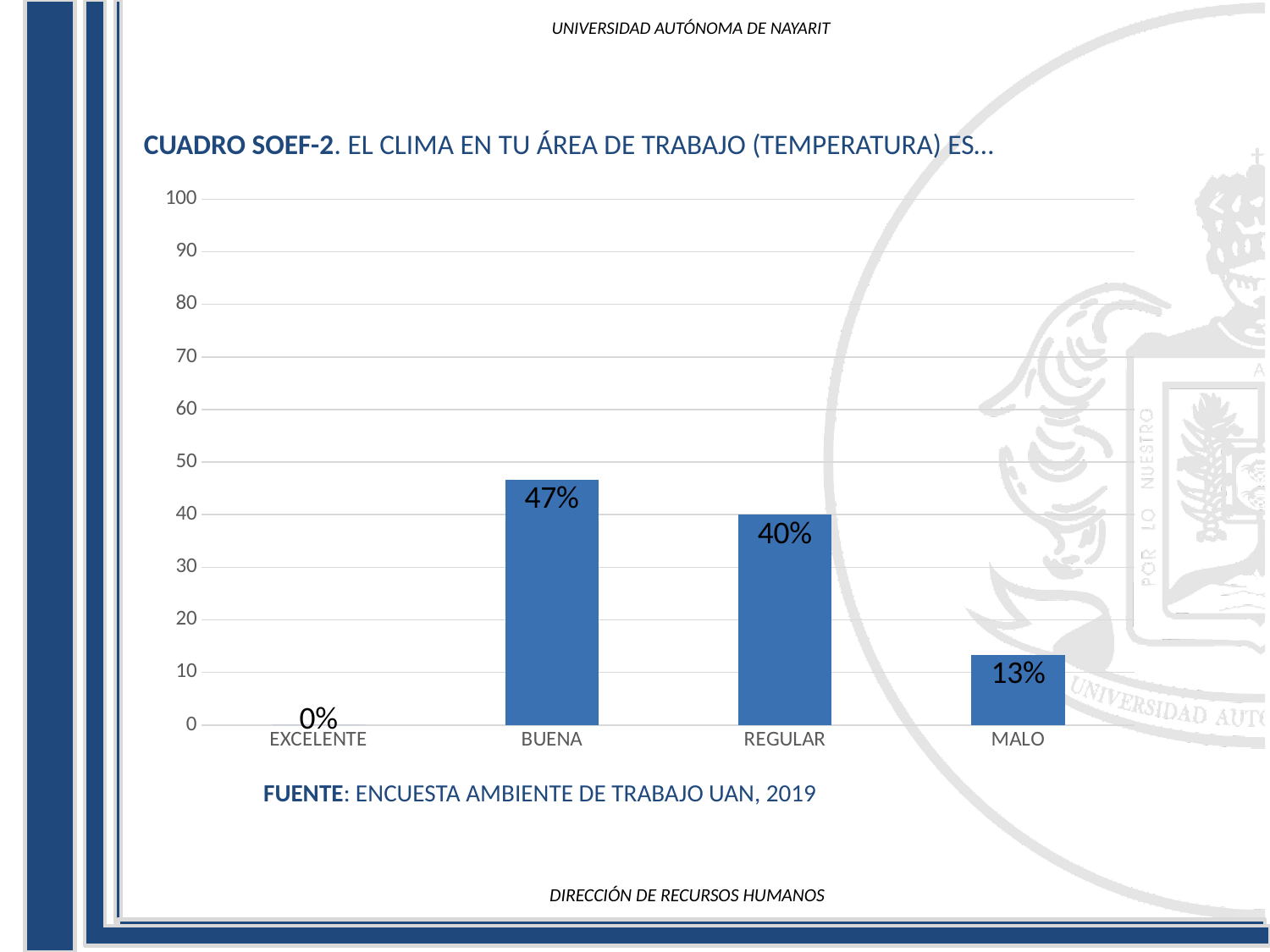
Which category has the highest value? BUENA Which is larger, the value for REGULAR or the value for MALO? REGULAR How many categories are shown on the x axis? 4 What is the difference between the values for BUENA and REGULAR? 7% What kind of chart is shown on the slide? Bar chart What is the value for BUENA? 47% What source is cited below the chart? ENCUESTA AMBIENTE DE TRABAJO UAN, 2019 What is the value for EXCELENTE? 0% What is the value for REGULAR? 40% What is the difference between the values for REGULAR and MALO? 27% Which category has the lowest value? EXCELENTE What is the value for MALO? 13%